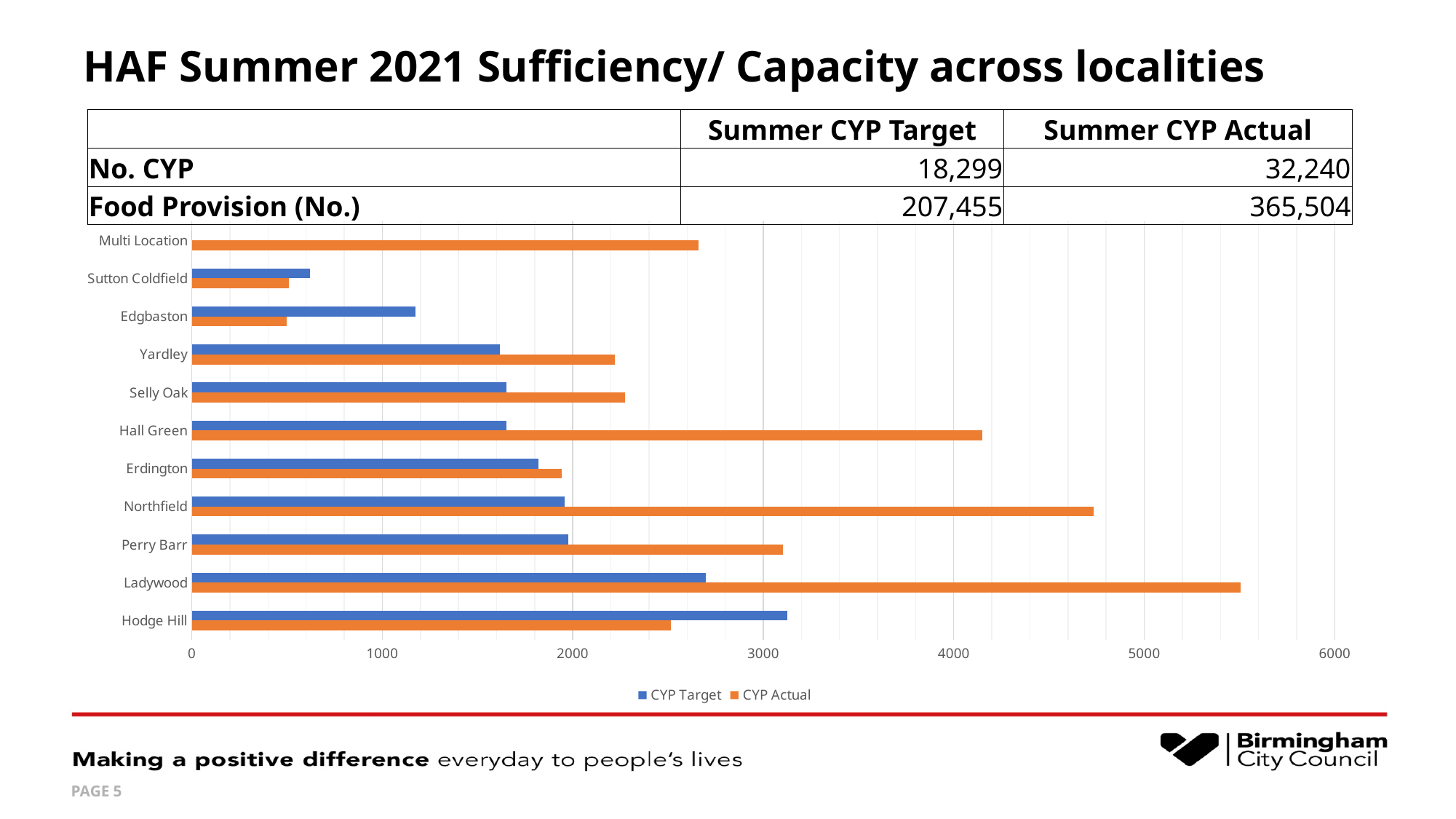
For Hall Green, which is larger: CYP Target or CYP Actual? CYP Actual How many series does the chart legend list? 2 What kind of chart is shown on the slide? bar chart How many localities are plotted on the chart? 11 Which locality has the highest CYP Target value? Hodge Hill Is the CYP Actual value for Multi Location greater or less than 3000? less Which locality has the highest CYP Actual value? Ladywood For Hodge Hill, which is larger: CYP Target or CYP Actual? CYP Target Is the CYP Actual value for Northfield greater or less than 4000? greater What colour represents the CYP Actual series in the chart? orange Is the CYP Actual value for Ladywood greater or less than 5000? greater